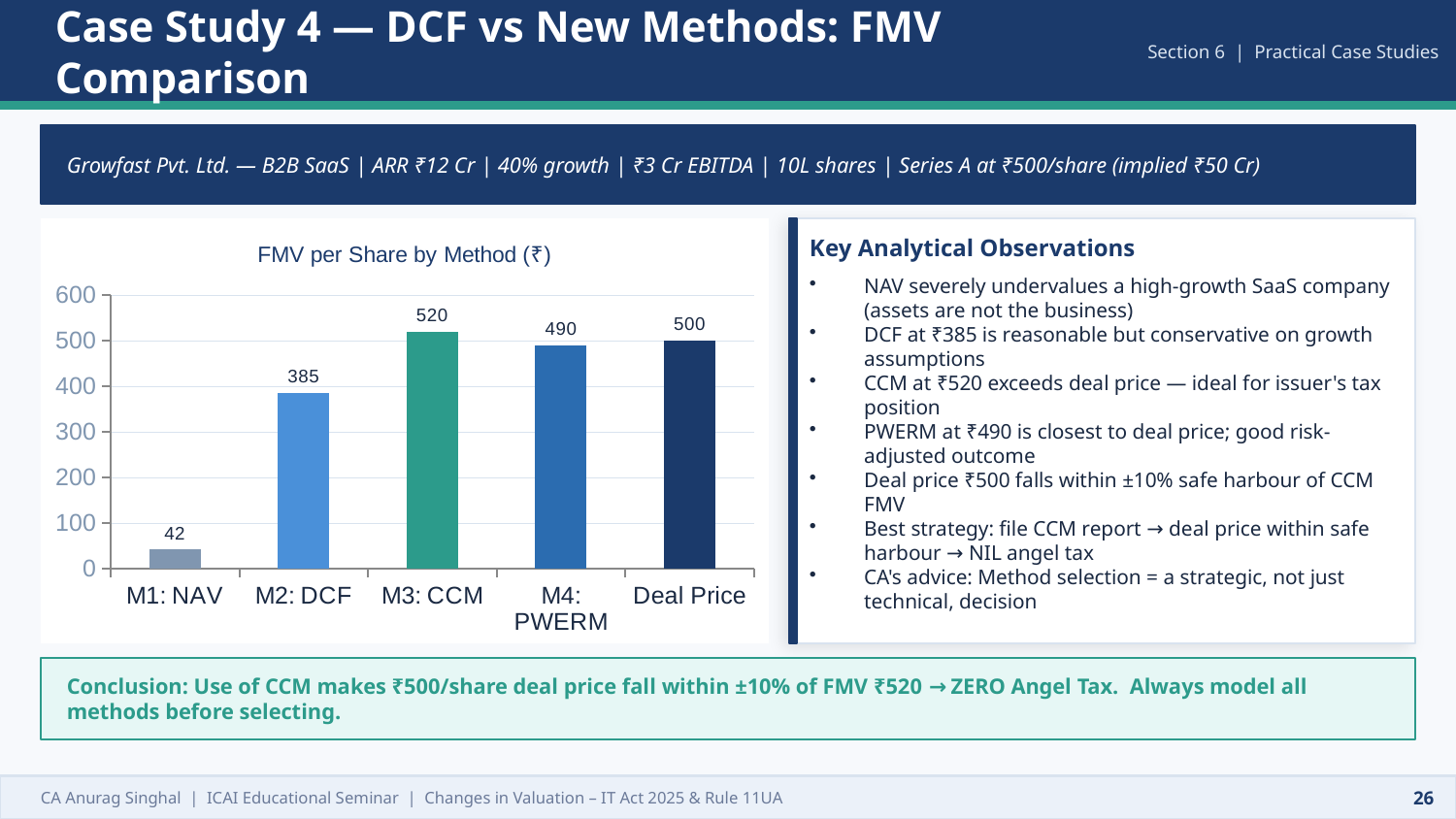
What is the value shown for M4: PWERM? 490 What is the FMV per share for M2: DCF? 385 What type of chart is shown on the slide? Bar chart Which category has the lowest value in the chart? M1: NAV What is the value shown for M3: CCM? 520 Which method has the highest FMV per share? M3: CCM How many categories are shown on the x axis of the chart? 5 Which is larger, the value for M4: PWERM or the value for Deal Price? Deal Price What is the title of the chart? FMV per Share by Method (₹) What is the difference between the M2: DCF value and the M1: NAV value? 343 What is the difference between the M3: CCM value and the Deal Price value? 20 What is the value shown for M1: NAV? 42